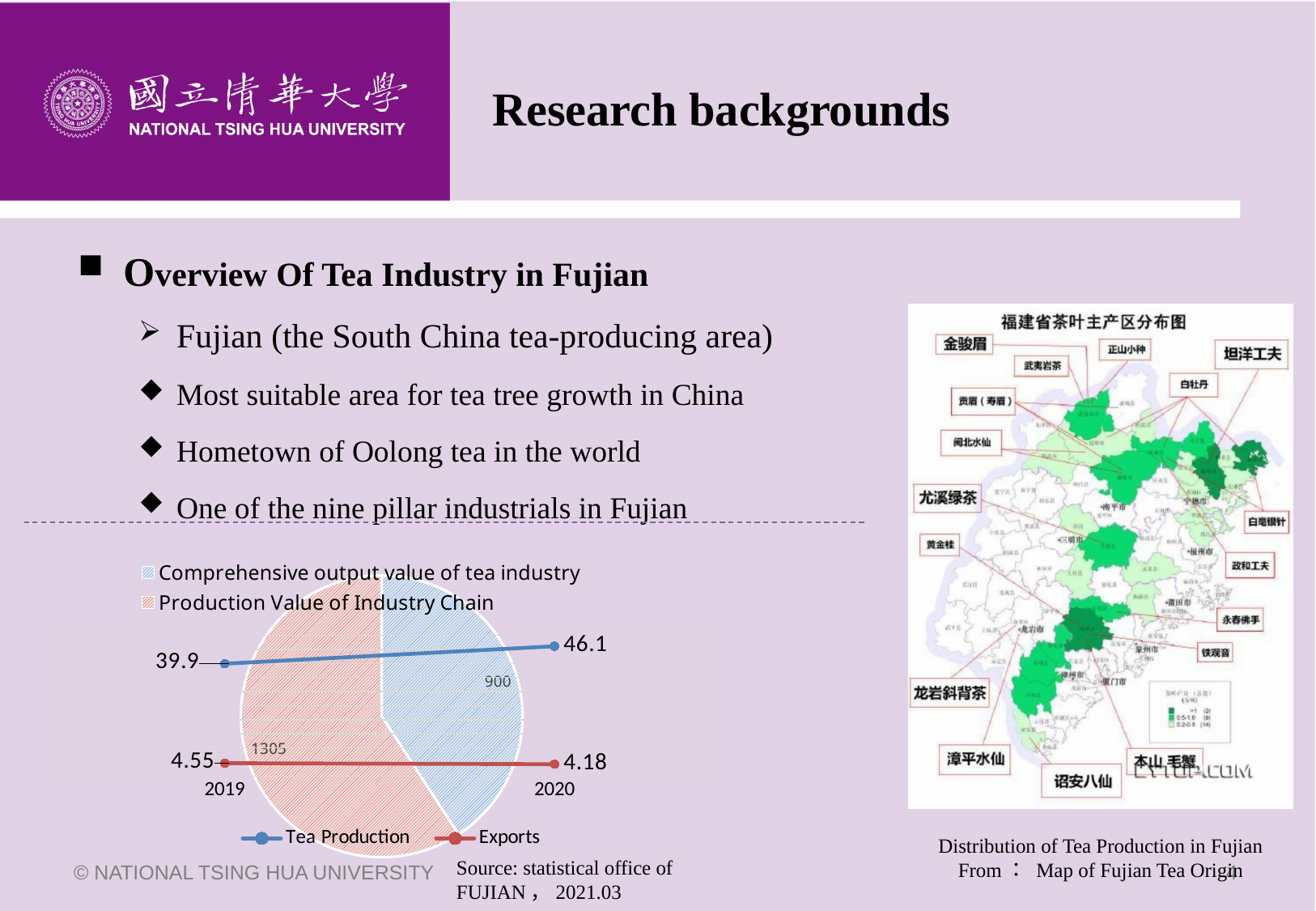
In the line chart, what is the difference between Tea Production in 2020 and in 2019? 6.2 In the line chart, what is the value for Tea Production in 2019? 39.9 In the pie chart, which slice is larger: Comprehensive output value of tea industry or Production Value of Industry Chain? Production Value of Industry Chain In the pie chart, what is the value for Comprehensive output value of tea industry? 900 In the line chart, what is the value for Exports in 2019? 4.55 In the pie chart, what is the value for Production Value of Industry Chain? 1305 In the line chart, does Exports rise or fall from 2019 to 2020? fall In the pie chart, how many slices are there? 2 In the line chart, what is the value for Tea Production in 2020? 46.1 In the line chart, what is the value for Exports in 2020? 4.18 In the line chart, how many series does the legend list? 2 In the line chart, does Tea Production rise or fall from 2019 to 2020? rise